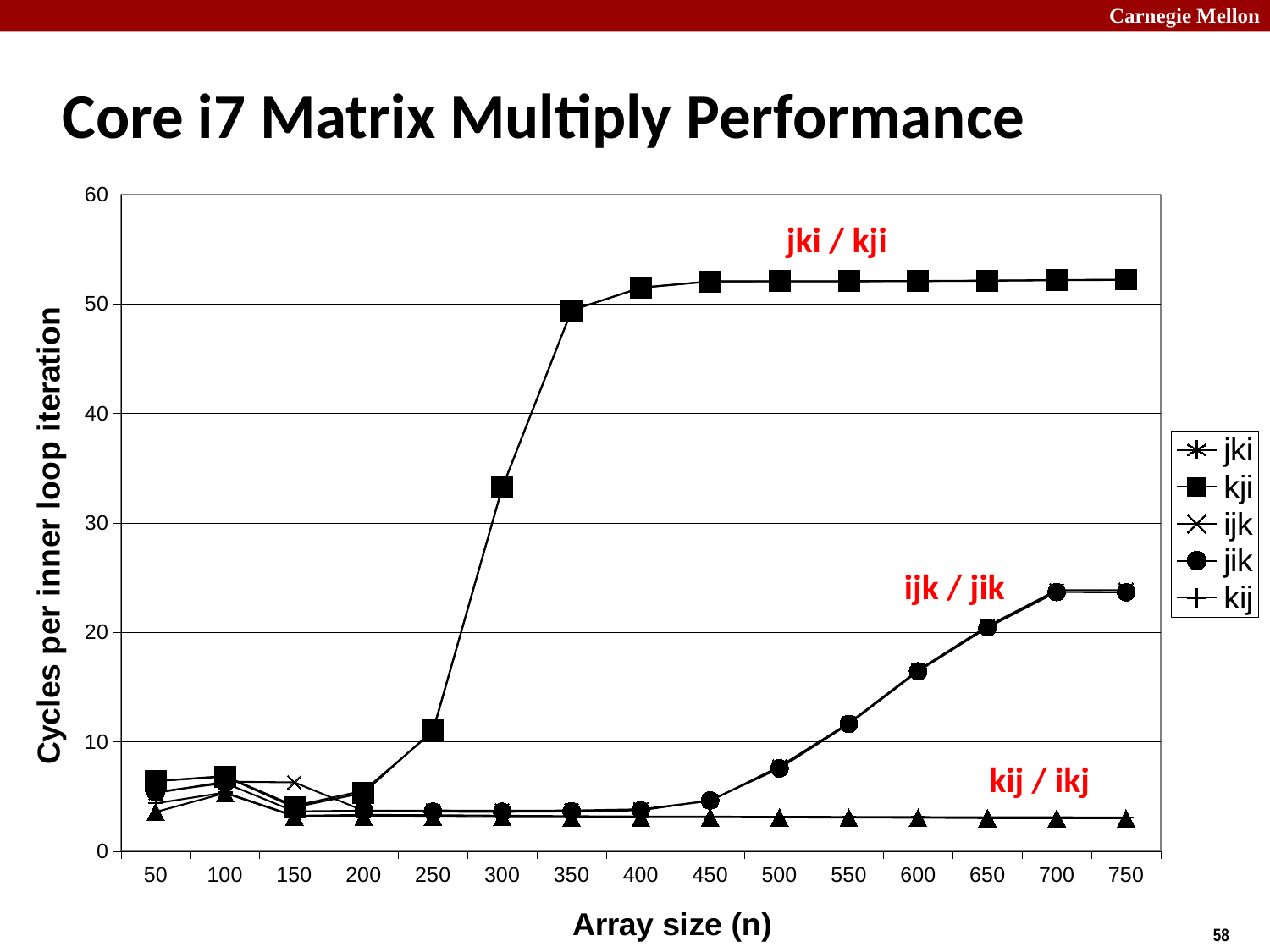
Does the kji series rise or fall as the array size goes from 200 to 450? rise Is the value for jik at array size 750 greater or less than 20? greater Is the value for kji at array size 750 greater or less than 50? greater Is the value for kji at array size 300 greater or less than 30? greater How many series does the legend list? 5 What kind of chart is shown on the slide? line chart What is the label of the y axis? Cycles per inner loop iteration At array size 750, which is larger: the value for kji or the value for kij? kji How many array sizes are plotted along the x axis? 15